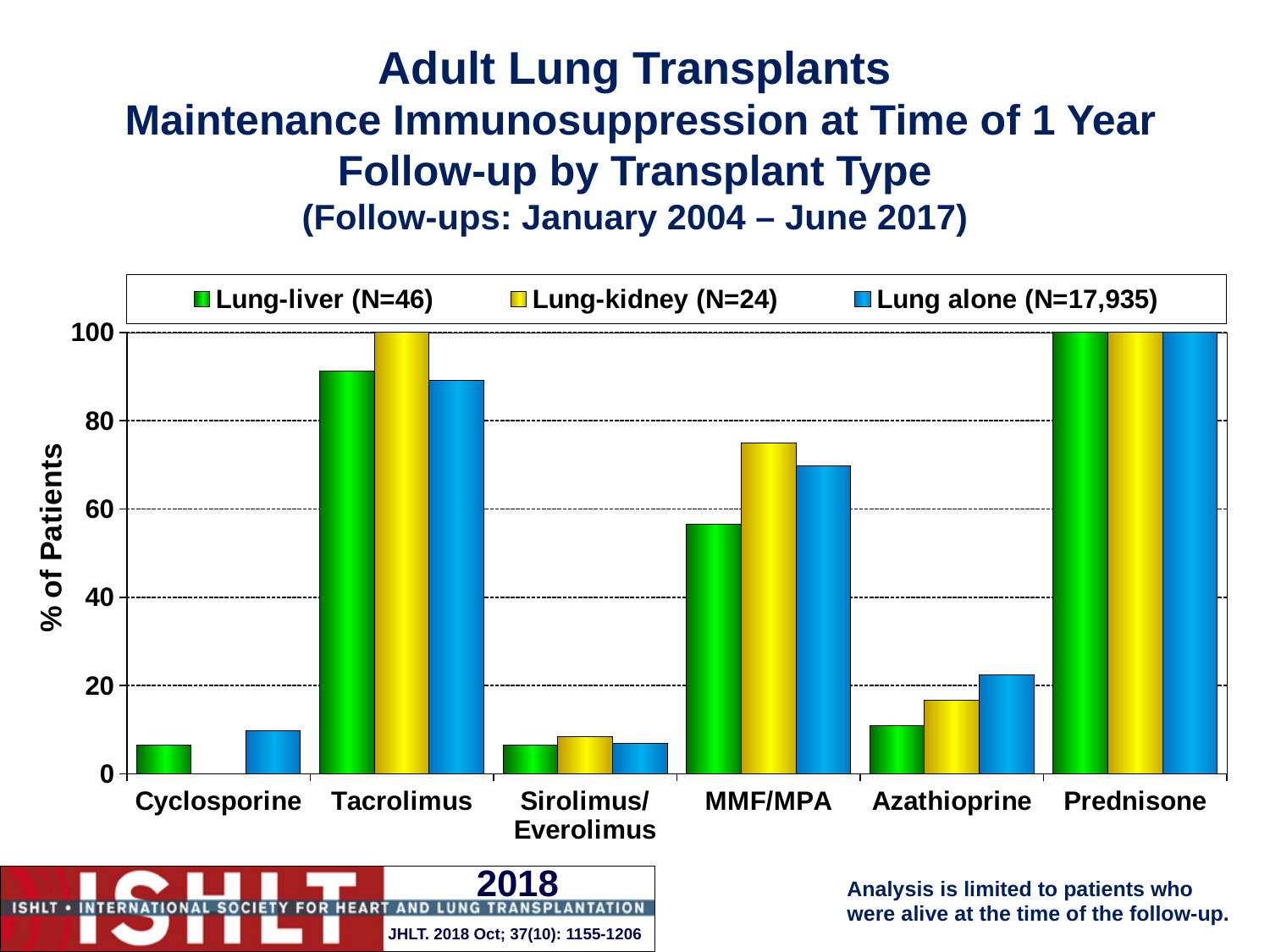
What is the value for Lung alone (N=17,935) for Prednisone? 100 For Cyclosporine, which is larger: the value for Lung-liver (N=46) or the value for Lung alone (N=17,935)? Lung alone (N=17,935) How many drug categories are shown along the x axis? 6 What is the value for Lung-kidney (N=24) for Tacrolimus? 100 What is the label of the y axis? % of Patients How many series does the legend list? 3 What kind of chart is shown on the slide? bar chart Is the value for Lung-liver (N=46) for MMF/MPA greater or less than 60? less Is the value for Lung alone (N=17,935) for Azathioprine greater or less than 20? greater Which series has the highest value for MMF/MPA? Lung-kidney (N=24) Is the value for Lung-liver (N=46) for Tacrolimus greater or less than 80? greater Which series has the lowest value for Azathioprine? Lung-liver (N=46)